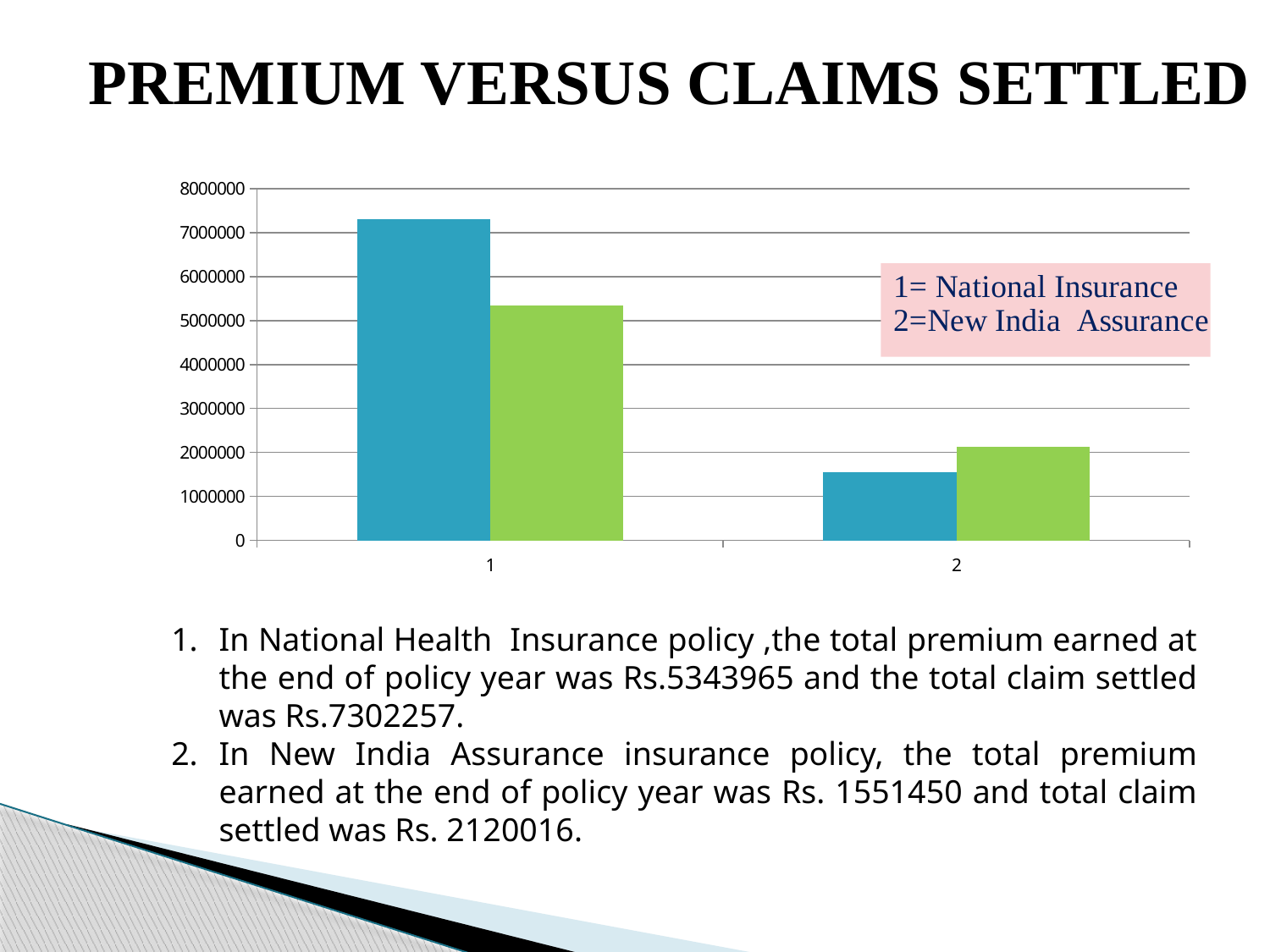
Is the value of the blue bar for category 2 greater or less than 2000000? less Which category has the shortest bar in the chart? 2 For category 1, which bar is taller, the blue bar or the green bar? the blue bar Is the value of the blue bar for category 1 greater or less than 7000000? greater What is the maximum value shown on the y axis of the chart? 8000000 What kind of chart is shown on the slide? bar chart How many categories are shown on the x axis of the chart? 2 Which category has the tallest bar in the chart? 1 Is the value of the green bar for category 1 greater or less than 5000000? greater According to the note on the chart, which insurer does category 1 represent? National Insurance For category 2, which bar is taller, the blue bar or the green bar? the green bar